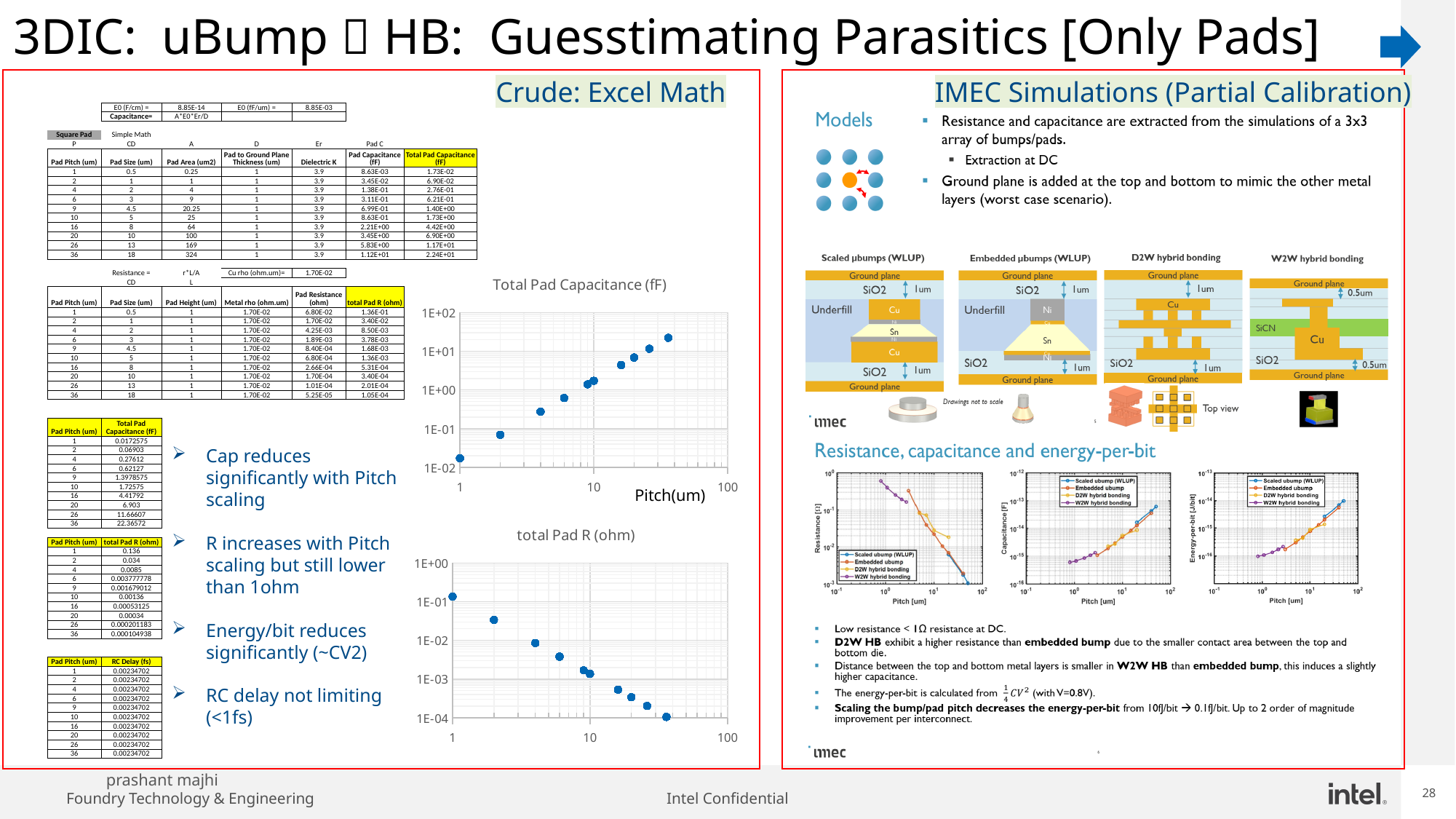
In the "Total Pad Capacitance (fF)" chart, is the value at the largest pitch plotted greater or less than 1E+01? greater How many data points are plotted in the "Total Pad Capacitance (fF)" chart? 10 What kind of chart is the "Total Pad Capacitance (fF)" chart? scatter chart In the "Total Pad Capacitance (fF)" chart, do the values rise or fall as pitch increases along the x axis? rise How many series does the legend list in the IMEC "Resistance" vs Pitch chart on the right side of the slide? 4 In the "total Pad R (ohm)" chart, is the value at the largest pitch plotted greater or less than 1E-03? less What is the x-axis label of the "Total Pad Capacitance (fF)" chart? Pitch(um) In the "total Pad R (ohm)" chart, which pitch has the highest resistance, the smallest pitch or the largest pitch? the smallest pitch In the "Total Pad Capacitance (fF)" chart, is the value at a pitch of 1 um greater or less than 1E-01? less In the "total Pad R (ohm)" chart, do the values rise or fall as pitch increases along the x axis? fall How many data points are plotted in the "total Pad R (ohm)" chart? 10